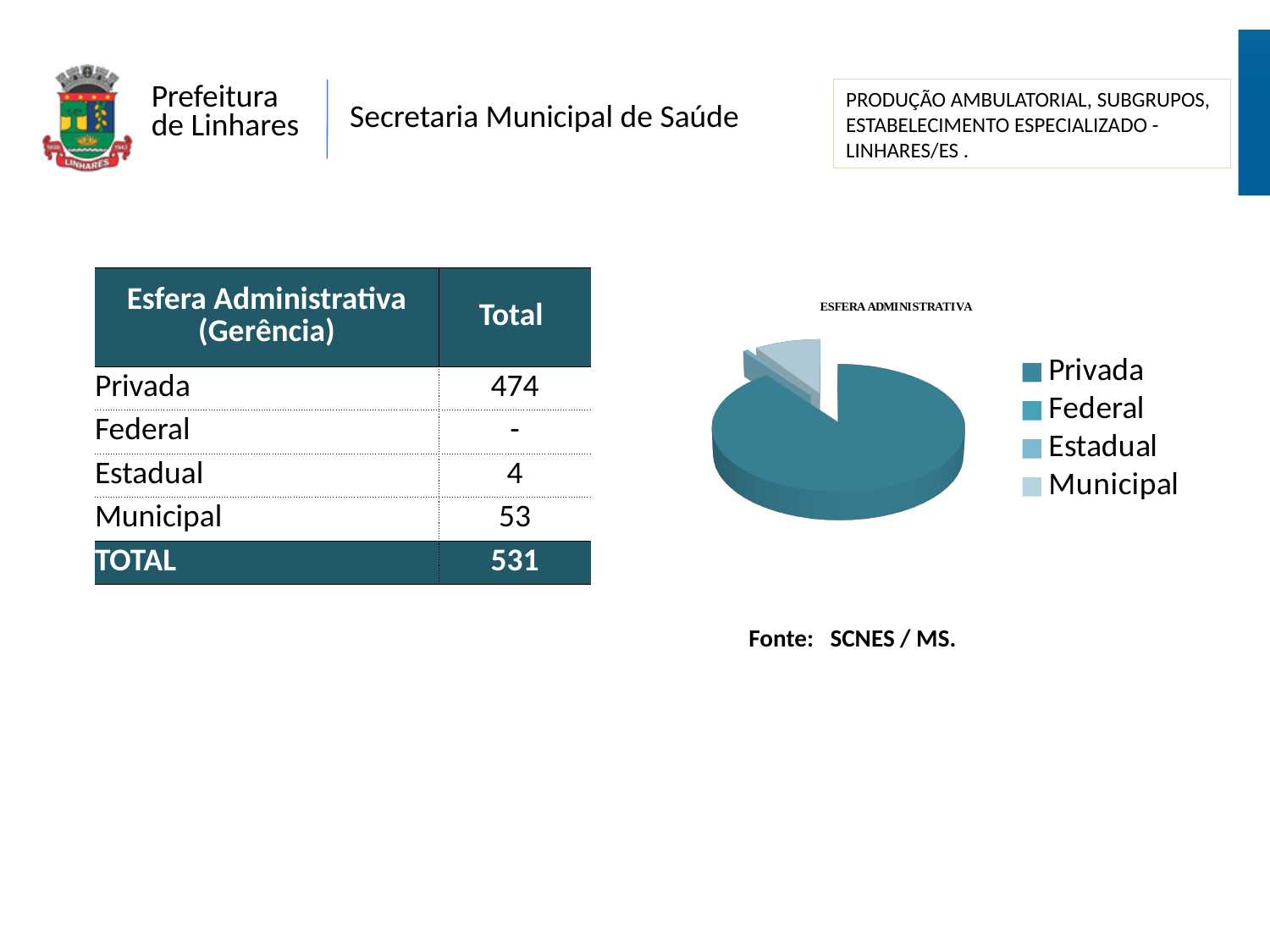
Which category has the largest slice in the pie chart? Privada What is the total for Estadual? 4 Which is larger, the value for Municipal or the value for Estadual? Municipal What is the total for Privada? 474 Which legend entry is listed first in the pie chart's legend? Privada What is the total for Municipal? 53 What value is shown for Federal in the table? - How many categories does the pie chart's legend list? 4 What is the overall TOTAL shown in the table? 531 What kind of chart is shown on the slide? pie chart What is the difference between the values for Privada and Municipal? 421 What is the title of the pie chart? ESFERA ADMINISTRATIVA